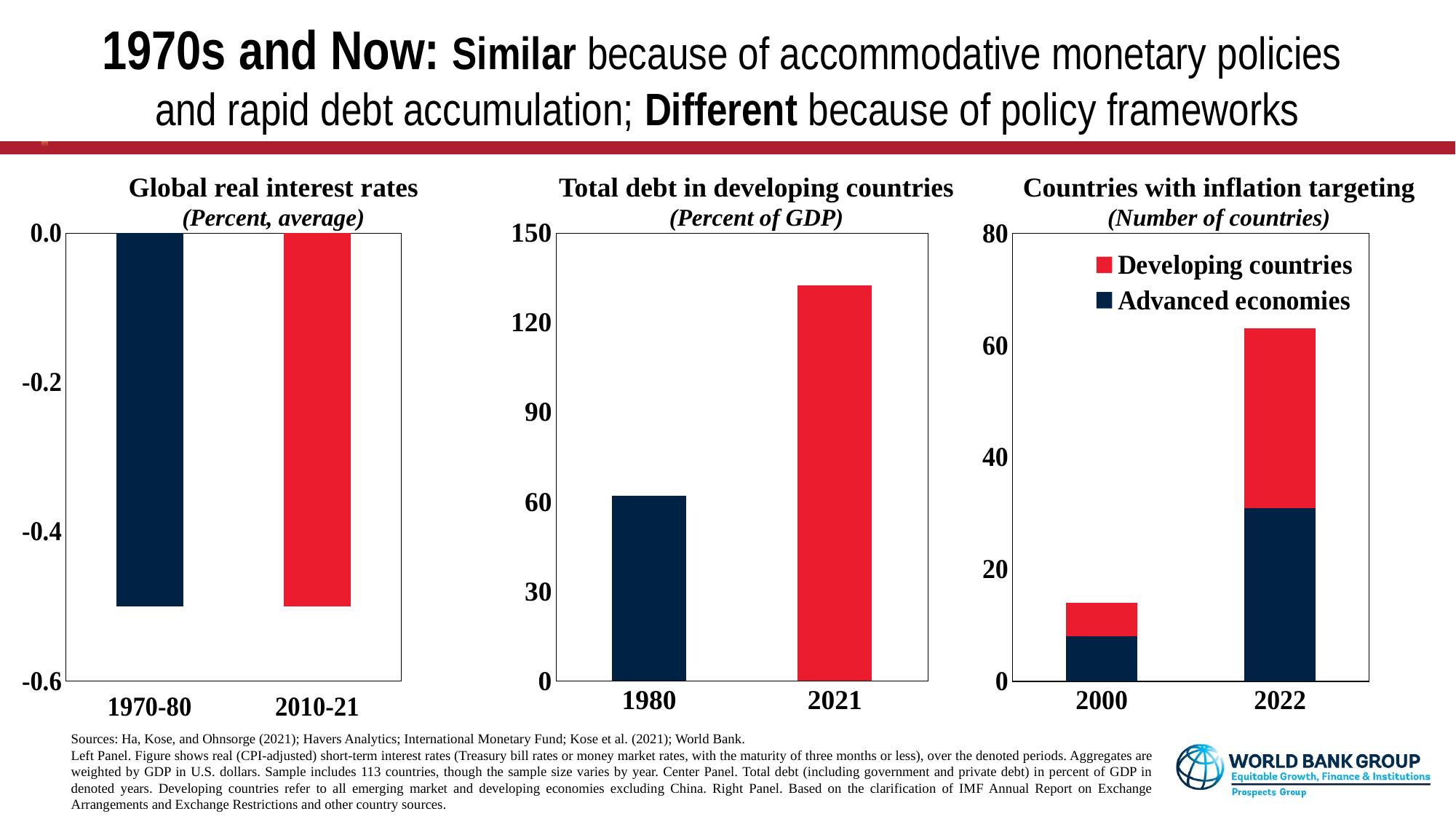
In the "Total debt in developing countries" chart, which year has the higher value, 1980 or 2021? 2021 In the "Countries with inflation targeting" chart, which series is shown in red? Developing countries In the "Countries with inflation targeting" chart, is the total for 2000 greater or less than 20? less In the "Countries with inflation targeting" chart, is the total for 2022 greater or less than 60? greater How many series does the legend list in the "Countries with inflation targeting" chart? 2 In the "Global real interest rates" chart, is the value for 1970-80 greater or less than -0.4? less How many categories are shown on the x axis of the "Total debt in developing countries" chart? 2 In the "Countries with inflation targeting" chart, which year has the higher total, 2000 or 2022? 2022 In the "Total debt in developing countries" chart, do values rise or fall from 1980 to 2021? rise What kind of chart is the "Global real interest rates" chart? bar chart